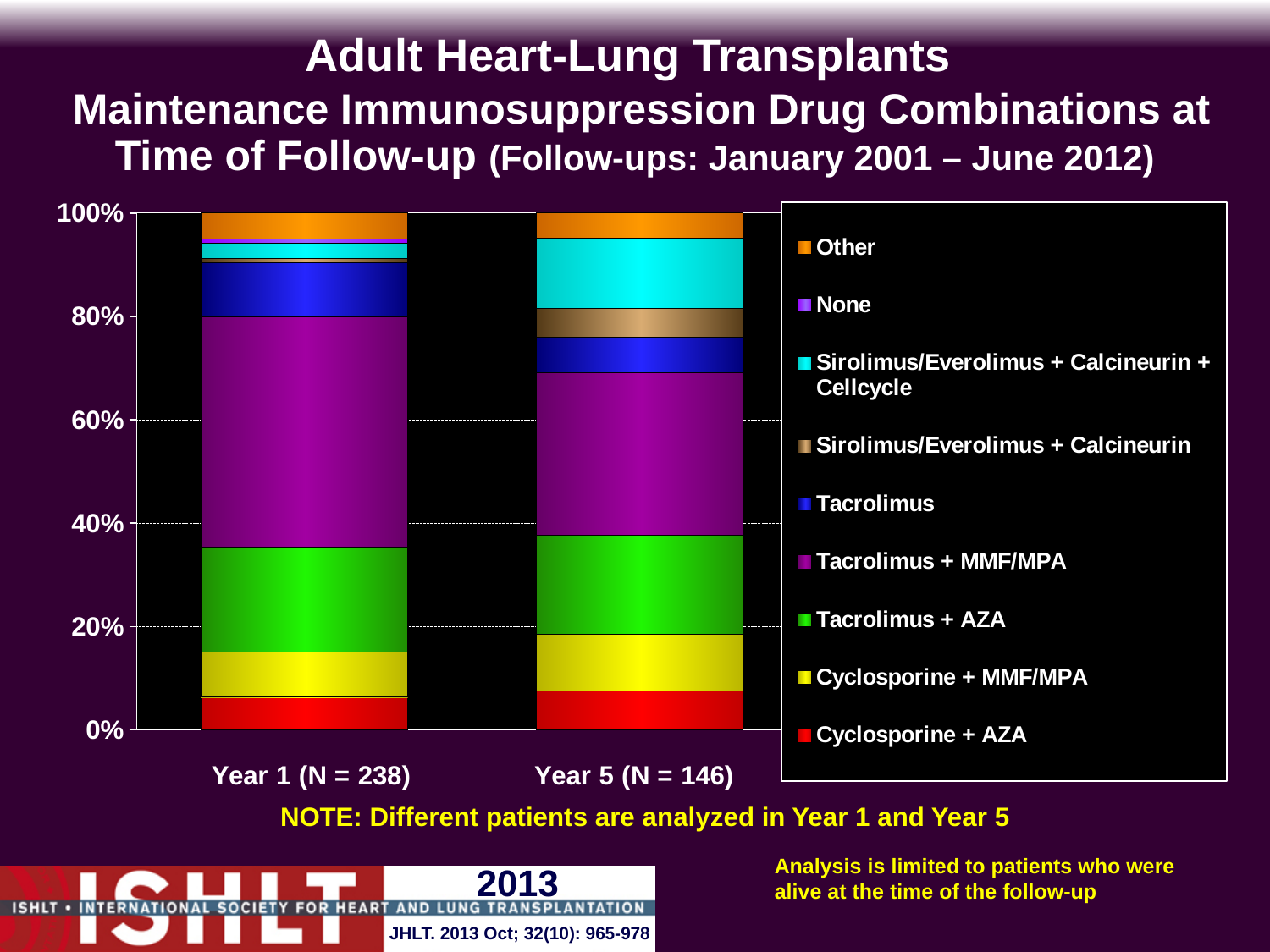
In the Year 1 bar, is the cumulative share at the top of the Tacrolimus + AZA segment greater or less than 40%? less In the Year 5 bar, is the cumulative share at the top of the Tacrolimus + MMF/MPA segment greater or less than 80%? less Which drug combination makes up the largest segment of the Year 5 bar? Tacrolimus + MMF/MPA How many drug combination series does the legend list? 9 What is the total height of each stacked bar on the percentage axis? 100% How many bars (follow-up years) are plotted in the chart? 2 Is the share of Sirolimus/Everolimus + Calcineurin + Cellcycle larger in Year 1 or Year 5? Year 5 Which drug combination makes up the largest segment of the Year 1 bar? Tacrolimus + MMF/MPA Is the share of Tacrolimus + MMF/MPA larger in Year 1 or Year 5? Year 1 What is the sample size (N) for the Year 1 bar? 238 What is the sample size (N) for the Year 5 bar? 146 What kind of chart is shown on the slide? Stacked bar chart